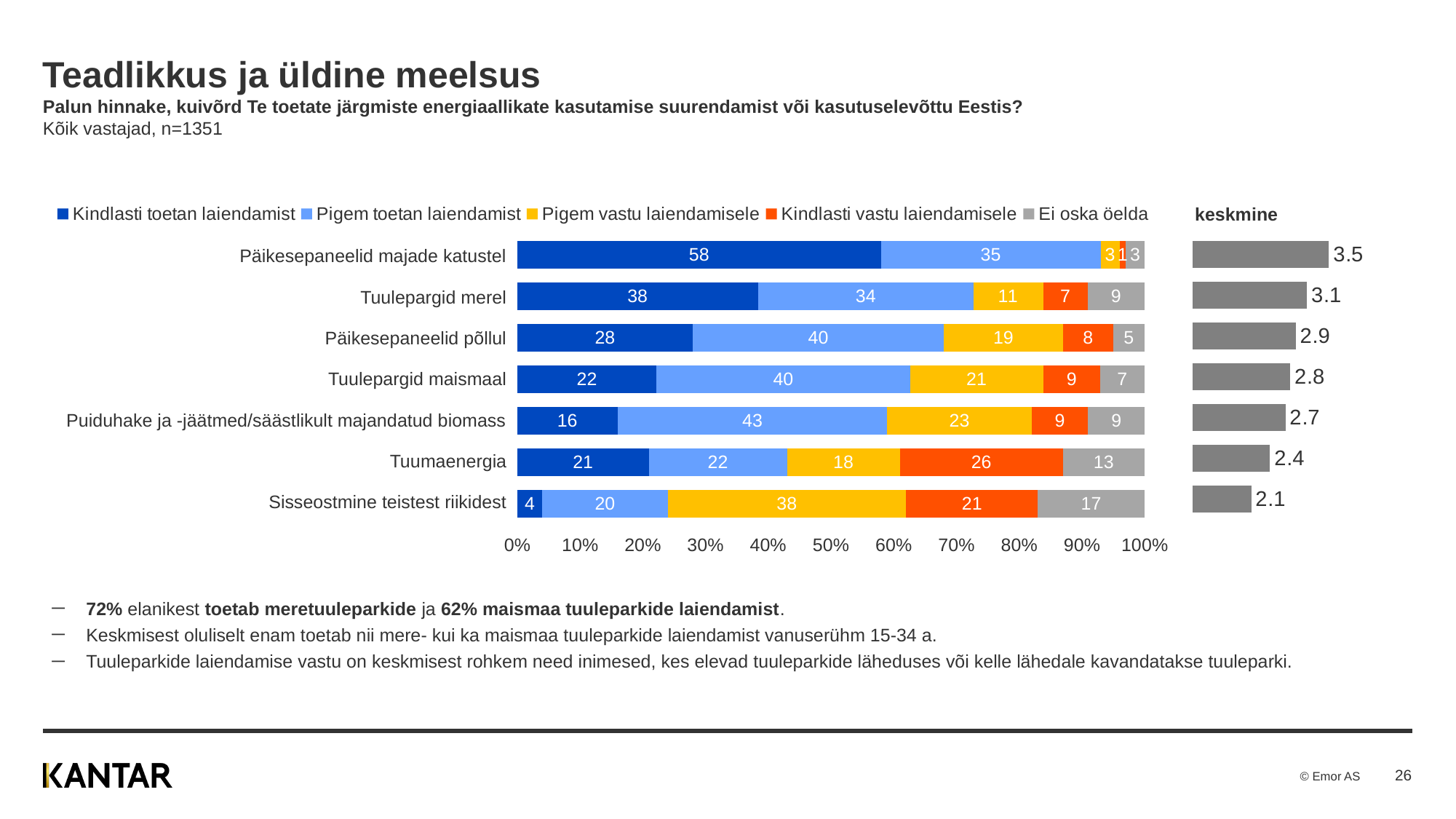
How many series does the legend of the stacked bar chart list? 5 In the stacked bar chart, what is the combined total of 'Kindlasti toetan laiendamist' and 'Pigem toetan laiendamist' for Tuulepargid merel? 72 In the stacked bar chart, what is the 'Kindlasti vastu laiendamisele' value for Tuumaenergia? 26 What kind of chart is the main chart on the slide? Stacked bar chart In the stacked bar chart, which is larger: the 'Ei oska öelda' value for Tuumaenergia or for Tuulepargid maismaal? Tuumaenergia In the stacked bar chart, what is the 'Pigem vastu laiendamisele' value for Sisseostmine teistest riikidest? 38 In the 'keskmine' chart, which category has the lowest value? Sisseostmine teistest riikidest In the stacked bar chart, what is the 'Kindlasti toetan laiendamist' value for Päikesepaneelid majade katustel? 58 In the stacked bar chart, what is the difference between the 'Pigem toetan laiendamist' values for Puiduhake ja -jäätmed/säästlikult majandatud biomass and Tuumaenergia? 21 In the 'keskmine' chart, what is the value for Tuulepargid merel? 3.1 How many categories are shown in the stacked bar chart? 7 In the stacked bar chart, which category has the highest 'Kindlasti toetan laiendamist' value? Päikesepaneelid majade katustel